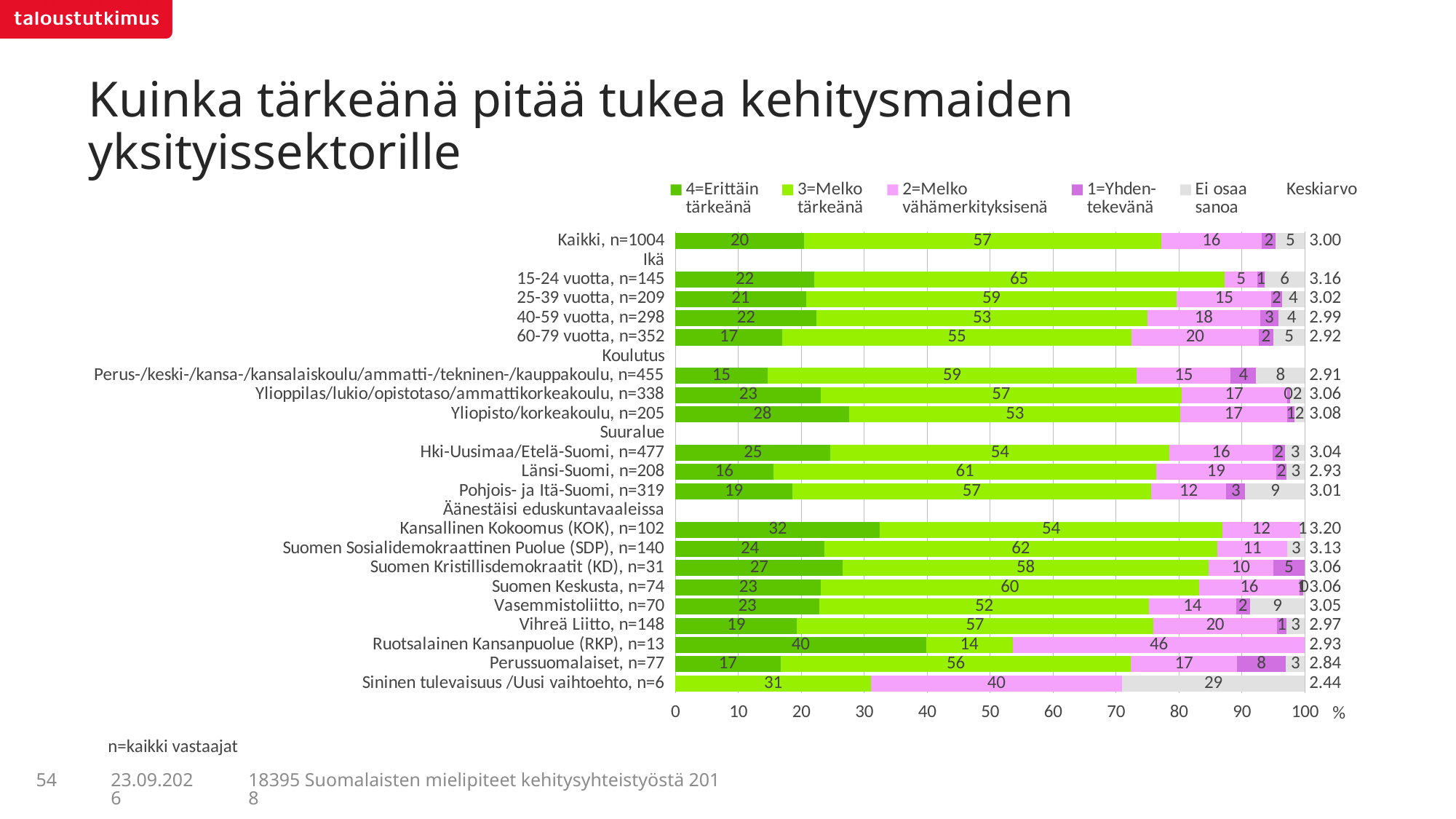
What percentage of Kansallinen Kokoomus (KOK) voters answered 4=Erittäin tärkeänä? 32 How many respondent groups (bars) are plotted in the chart? 21 What type of chart is shown on the slide? bar chart What percentage of all respondents (Kaikki, n=1004) answered 4=Erittäin tärkeänä? 20 Which has a larger share of 4=Erittäin tärkeänä responses: Yliopisto/korkeakoulu or Perus-/keski-/kansa-/kansalaiskoulu/ammatti-/tekninen-/kauppakoulu? Yliopisto/korkeakoulu What is the Keskiarvo (mean) for Kaikki, n=1004? 3.00 What percentage of Ruotsalainen Kansanpuolue (RKP) voters answered 2=Melko vähämerkityksisenä? 46 Which group has the highest Keskiarvo value? Kansallinen Kokoomus (KOK), n=102 What is the difference in the 3=Melko tärkeänä share between 15-24 vuotta and 60-79 vuotta? 10 What is the total of the stacked bar for Kaikki, n=1004? 100 Which group has the highest share of 4=Erittäin tärkeänä responses? Ruotsalainen Kansanpuolue (RKP), n=13 Which group has the lowest Keskiarvo value? Sininen tulevaisuus /Uusi vaihtoehto, n=6